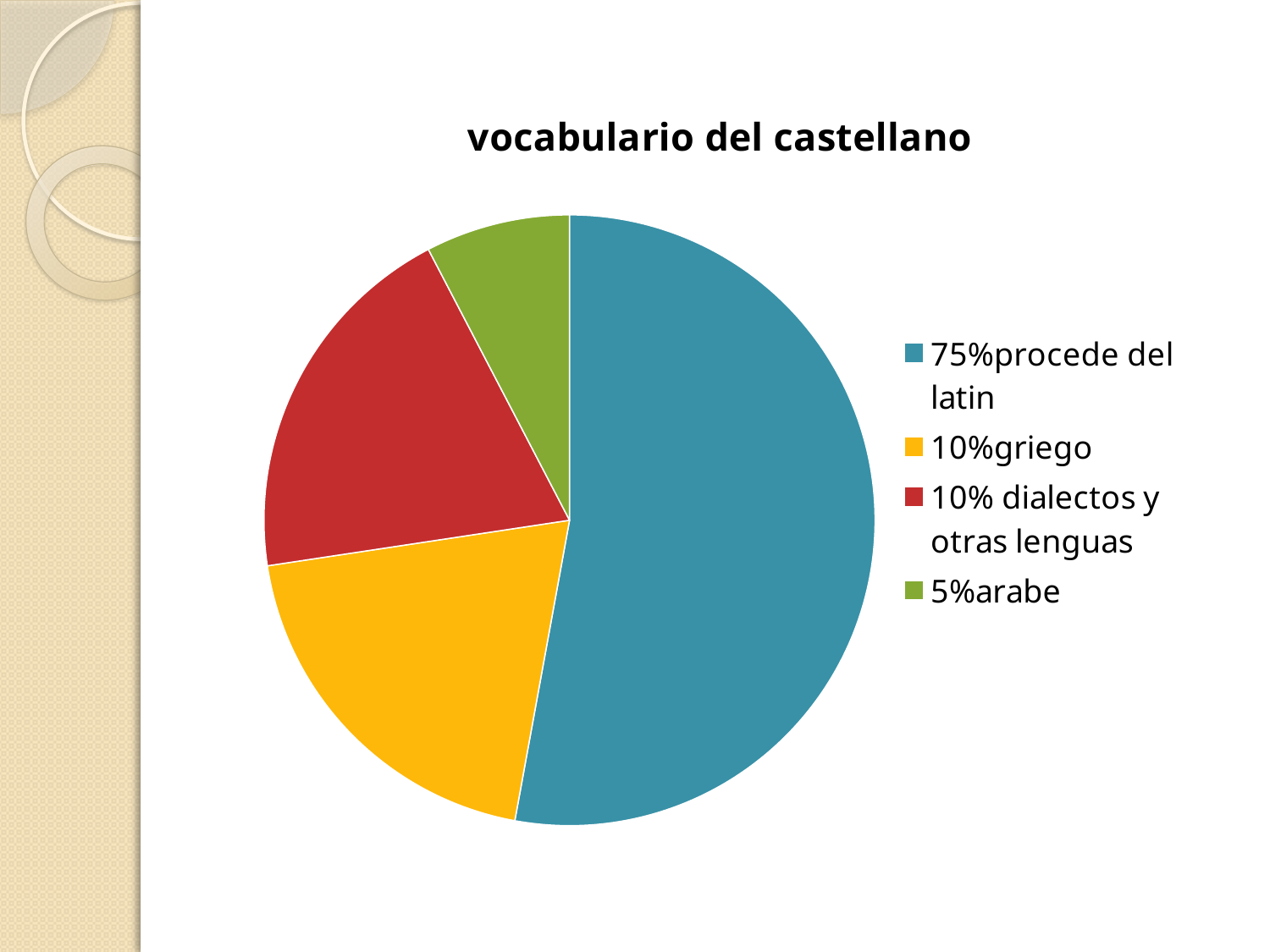
What is the title of the chart? vocabulario del castellano Which legend entry corresponds to the largest slice of the pie? 75%procede del latin What colour is the slice for "5%arabe"? green How many entries does the legend list? 4 How many slices does the pie chart have? 4 Is the slice for "75%procede del latin" greater or less than half of the pie? greater What kind of chart is shown on the slide? pie chart Which slice is larger, the one for "10%griego" or the one for "5%arabe"? 10%griego Which legend entry corresponds to the smallest slice of the pie? 5%arabe Which slice is larger, the one for "75%procede del latin" or the one for "5%arabe"? 75%procede del latin